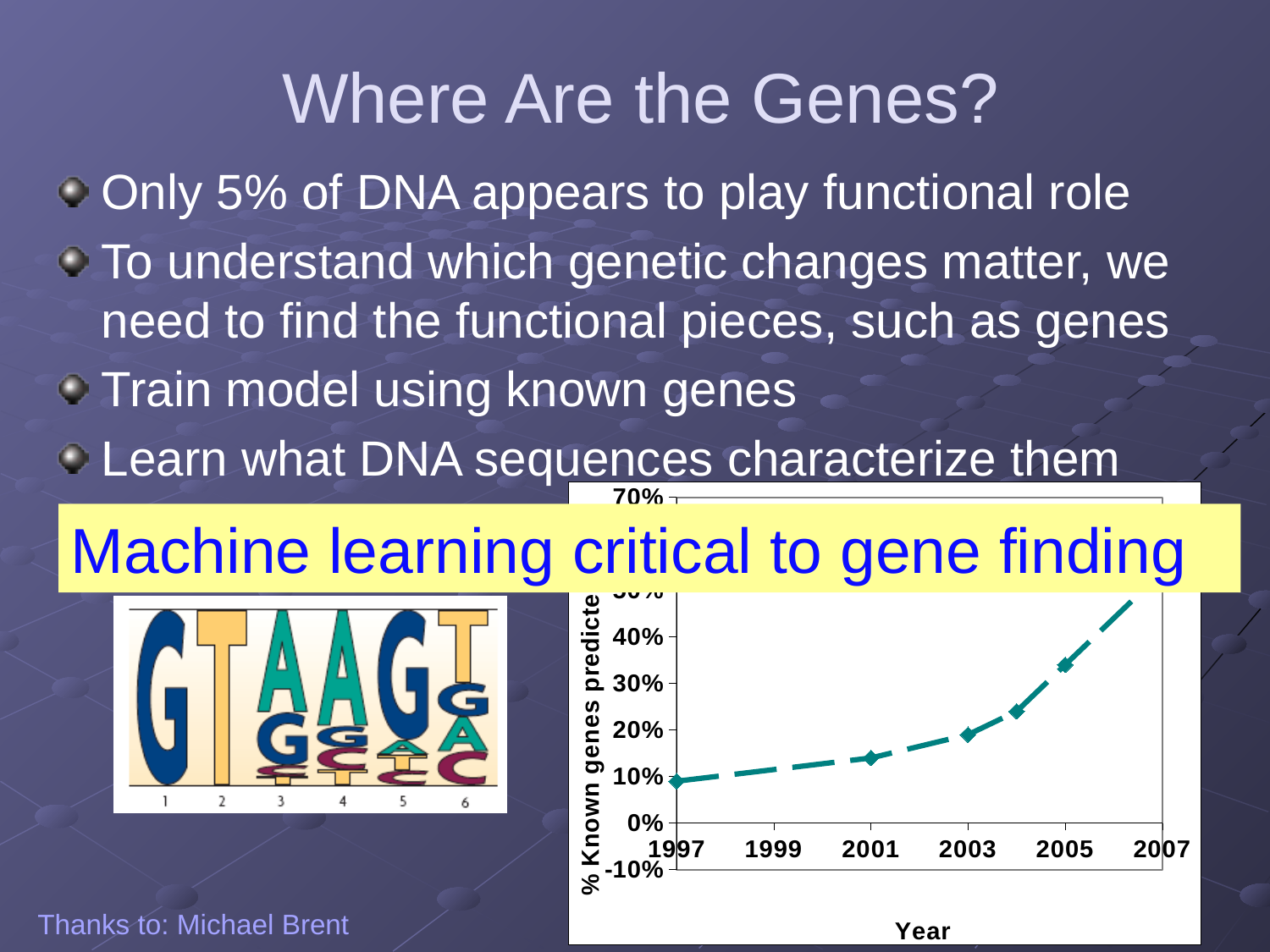
Which is larger, the value for 2005 or the value for 2001? 2005 What is the highest value shown on the y axis of the chart? 70% What kind of chart is shown on the slide? line chart Which year has the lowest plotted value? 1997 Is the value for 2001 greater or less than 10%? greater Is the value for 2005 greater or less than 40%? less Is the value for 2005 greater or less than 30%? greater Does the percentage of known genes predicted rise or fall from 1997 to 2007? rise What is the label on the x axis of the chart? Year